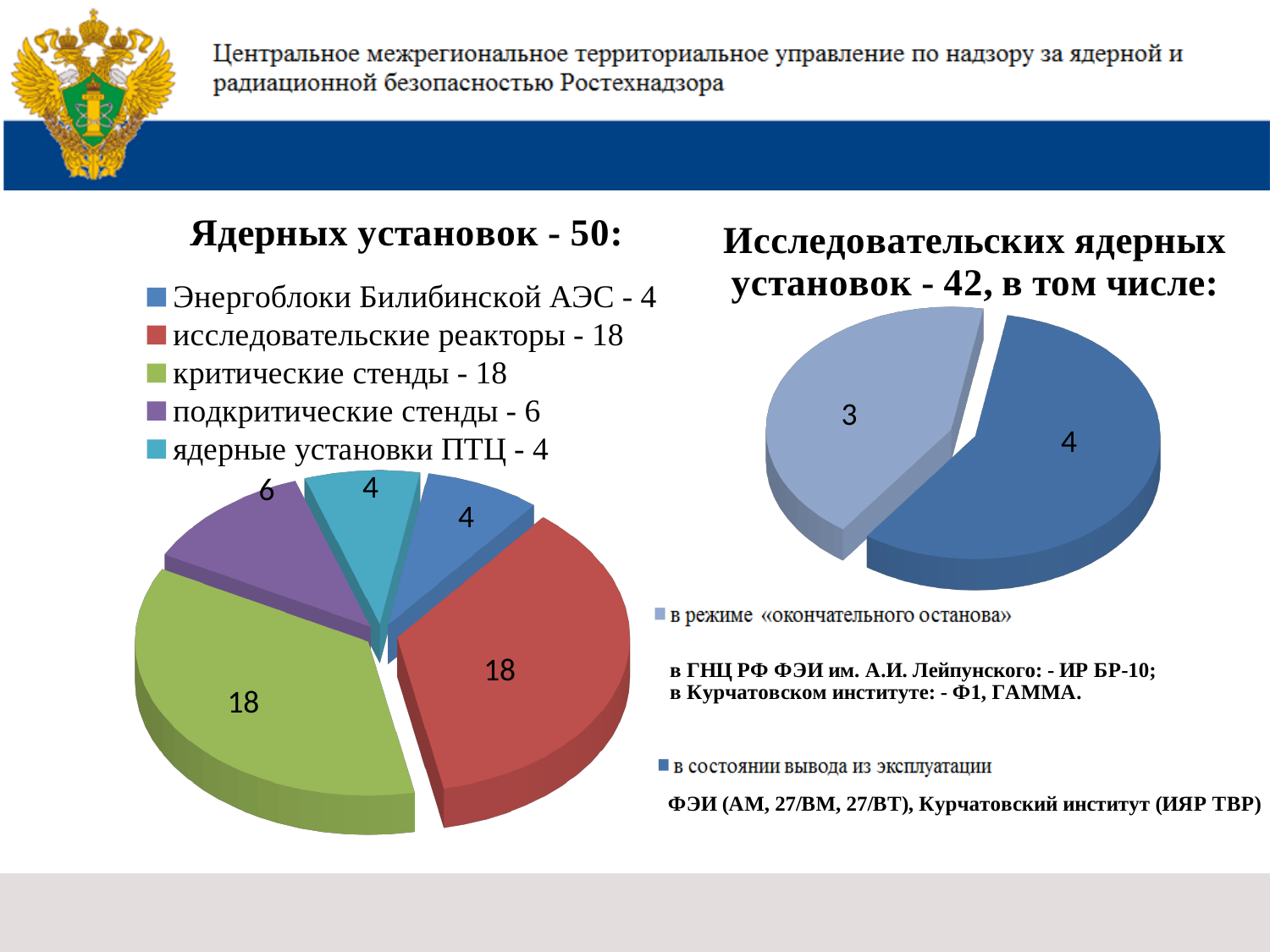
On the left chart titled "Ядерных установок - 50:", what is the value for "Энергоблоки Билибинской АЭС"? 4 On the left chart titled "Ядерных установок - 50:", what is the difference between the values for "критические стенды" and "подкритические стенды"? 12 On the right chart titled "Исследовательских ядерных установок - 42, в том числе:", which category has the largest slice? в состоянии вывода из эксплуатации On the left chart titled "Ядерных установок - 50:", what share of the pie does "подкритические стенды" represent? 12% On the right chart titled "Исследовательских ядерных установок - 42, в том числе:", how many slices does the pie have? 2 On the left chart titled "Ядерных установок - 50:", which is larger: "подкритические стенды" or "ядерные установки ПТЦ"? подкритические стенды On the right chart titled "Исследовательских ядерных установок - 42, в том числе:", what is the value for "в состоянии вывода из эксплуатации"? 4 What kind of chart is the left chart titled "Ядерных установок - 50:"? pie chart On the right chart titled "Исследовательских ядерных установок - 42, в том числе:", what is the value for "в режиме «окончательного останова»"? 3 On the left chart titled "Ядерных установок - 50:", how many slices does the pie have? 5 On the left chart titled "Ядерных установок - 50:", what is the value for "подкритические стенды"? 6 On the left chart titled "Ядерных установок - 50:", what is the value for "исследовательские реакторы"? 18